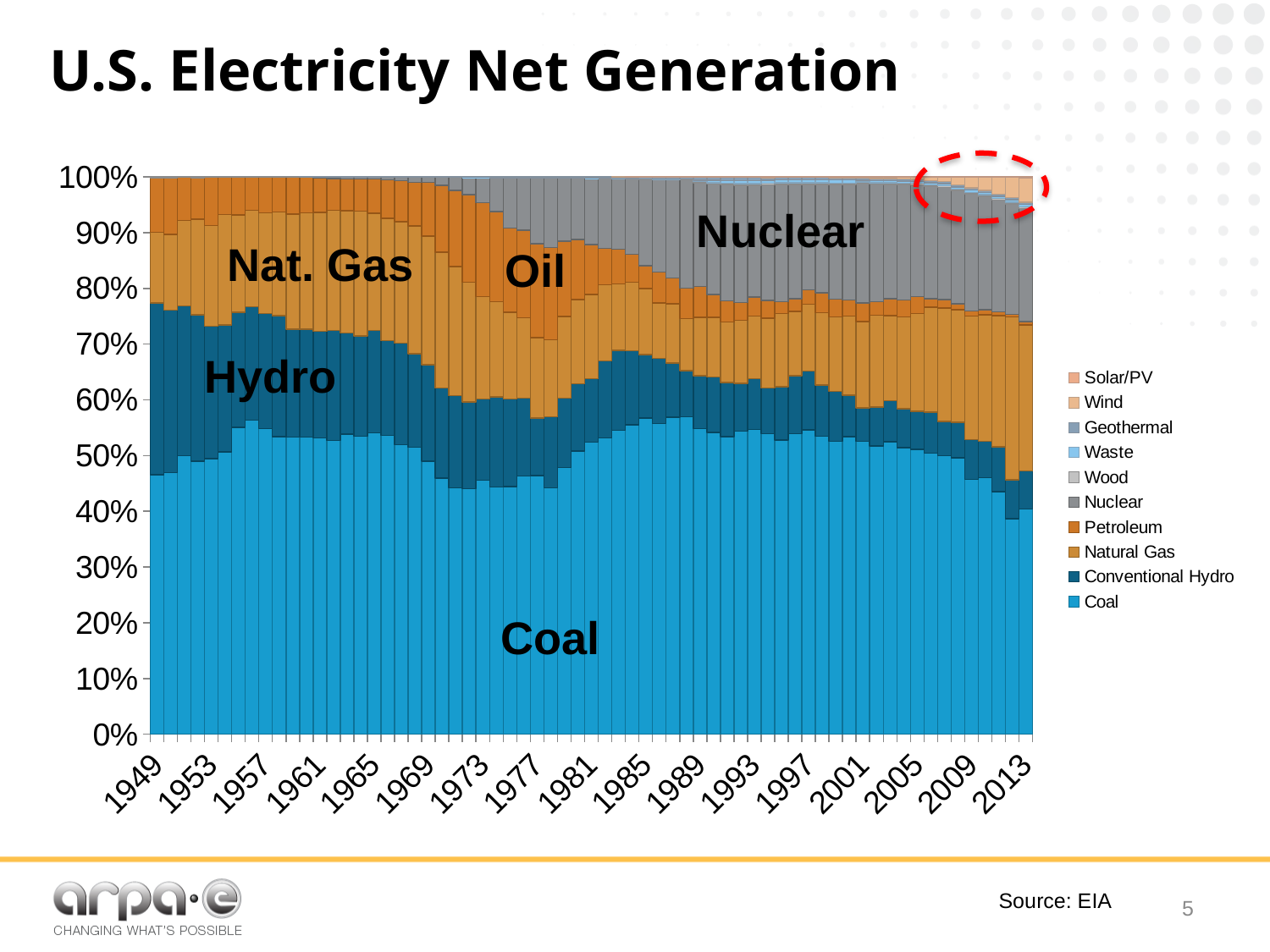
Which source has the largest share of generation in 1949? Coal How many series does the legend list? 10 In 1949, which is larger: the share of Coal or the share of Conventional Hydro? Coal Is the Coal share in 2013 greater or less than 50%? less Is the Coal share in 1985 greater or less than 50%? greater Is the Coal share in 1949 greater or less than 40%? greater Does the Nuclear share rise or fall from 1969 to 1989? Rise Does the Coal share rise or fall from 1985 to 2013? Fall Which series forms the bottom segment of each bar? Coal What kind of chart is shown on the slide? Stacked bar chart What source is cited for the chart data? EIA What is the title of the chart? U.S. Electricity Net Generation